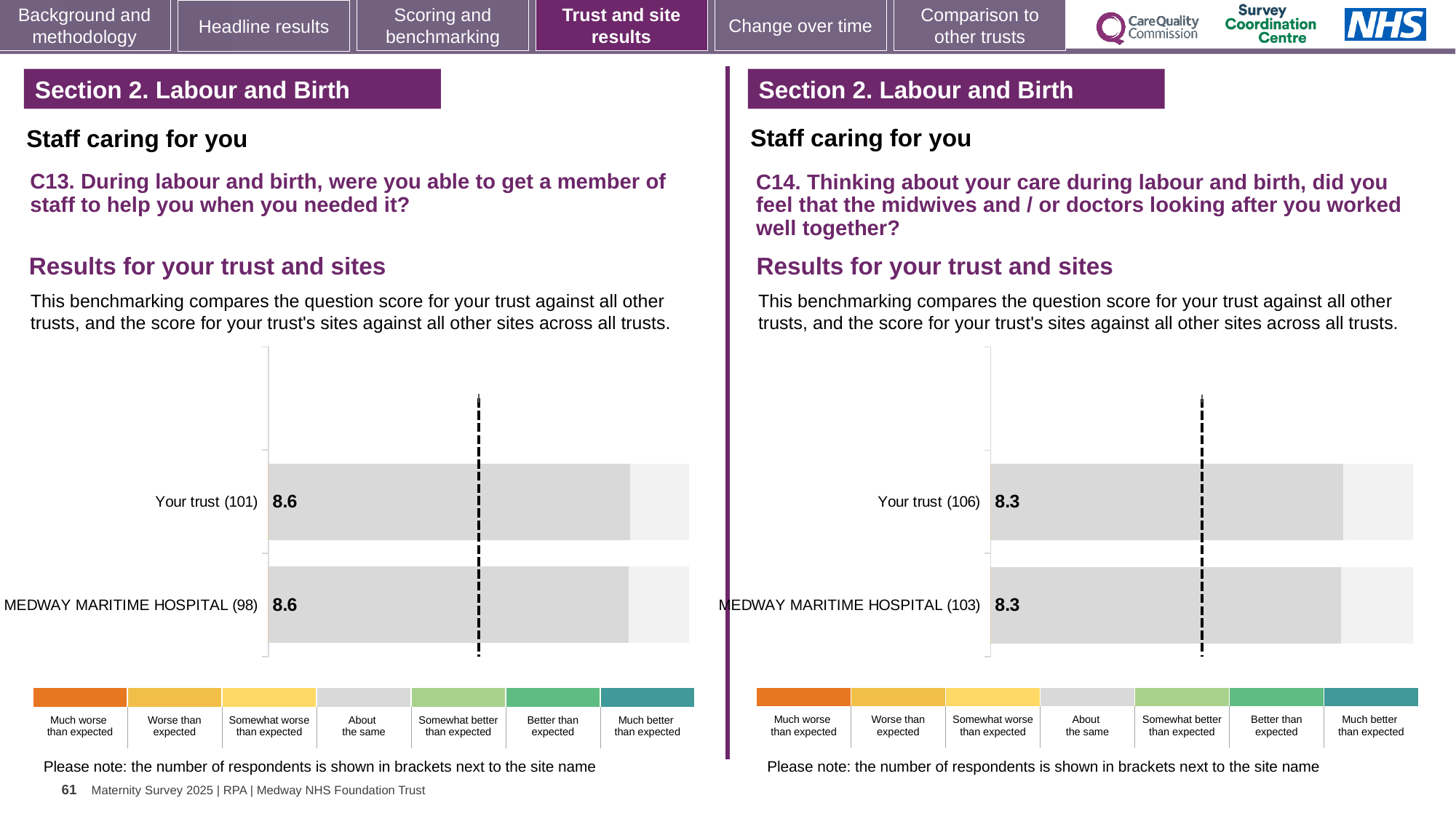
Is the Your trust score on the C13 chart (left) larger or smaller than the Your trust score on the C14 chart (right)? Larger On the C14 chart (right), what is the score for Your trust? 8.3 On the C14 chart (right), what is the score for MEDWAY MARITIME HOSPITAL? 8.3 On the C14 chart (right), what is the difference between the Your trust score and the MEDWAY MARITIME HOSPITAL score? 0 What kind of chart is used on the C13 chart (left)? Bar chart On the C13 chart (left), how many respondents are shown in brackets for Your trust? 101 On the C13 chart (left), what is the score for Your trust? 8.6 How many bars are plotted on the C14 chart (right)? 2 On the C14 chart (right), how many respondents are shown in brackets for MEDWAY MARITIME HOSPITAL? 103 On the C13 chart (left), what is the score for MEDWAY MARITIME HOSPITAL? 8.6 On the C13 chart (left), what is the difference between the Your trust score and the MEDWAY MARITIME HOSPITAL score? 0 How many bars are plotted on the C13 chart (left)? 2